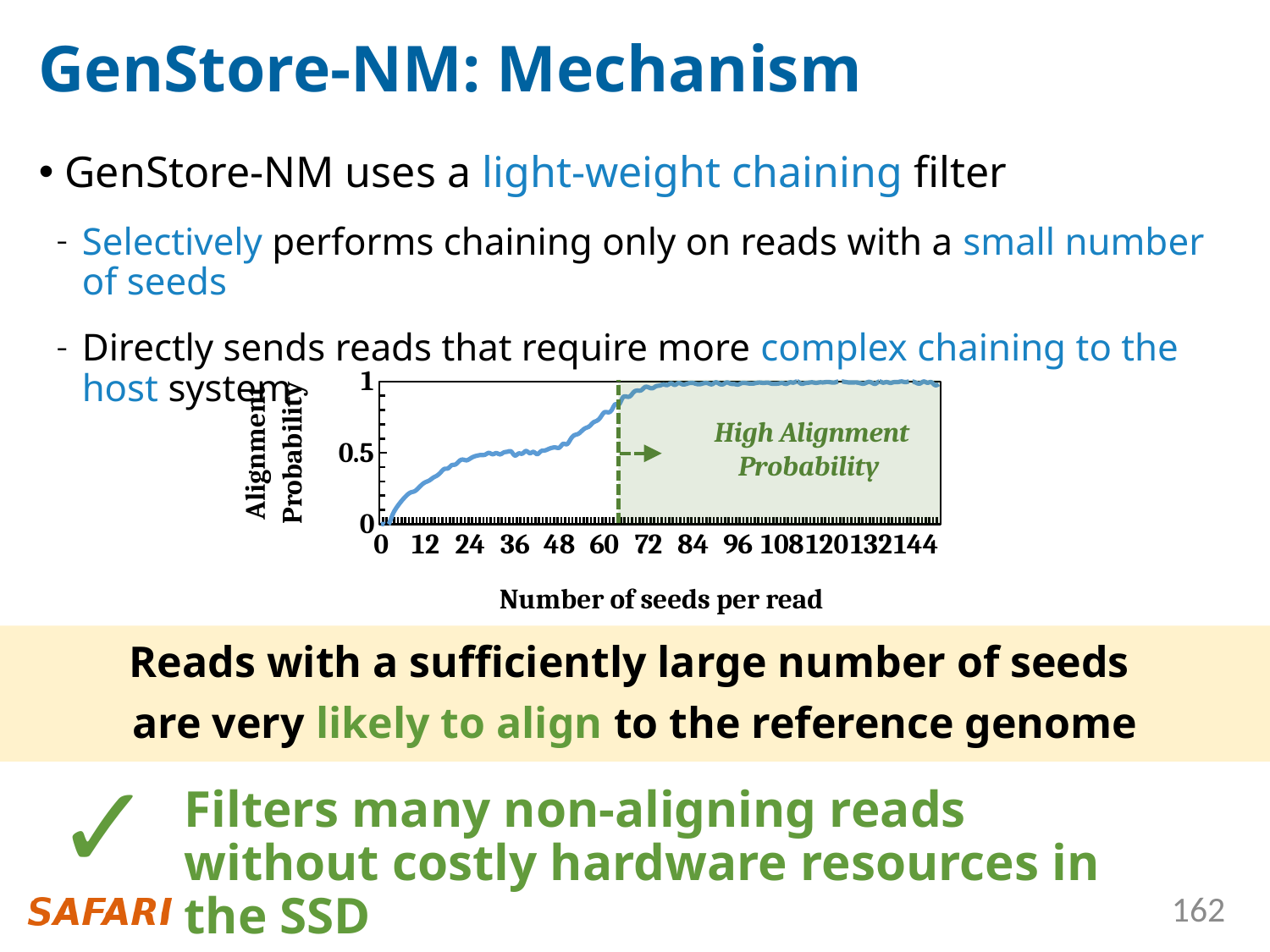
Is the alignment probability at 120 seeds per read greater or less than 0.5? greater Does the alignment probability rise or fall as the number of seeds per read increases? rise How many tick labels are shown on the x axis? 13 Is the alignment probability at 12 seeds per read greater or less than 0.5? less Is the alignment probability at 96 seeds per read greater or less than 0.5? greater What kind of chart is shown on the slide? line chart What is the label of the x axis of the chart? Number of seeds per read What is the highest tick value shown on the y axis? 1 What text labels the shaded region on the right side of the chart? High Alignment Probability Which has a higher alignment probability: 24 seeds per read or 96 seeds per read? 96 seeds per read What is the largest tick value shown on the x axis? 144